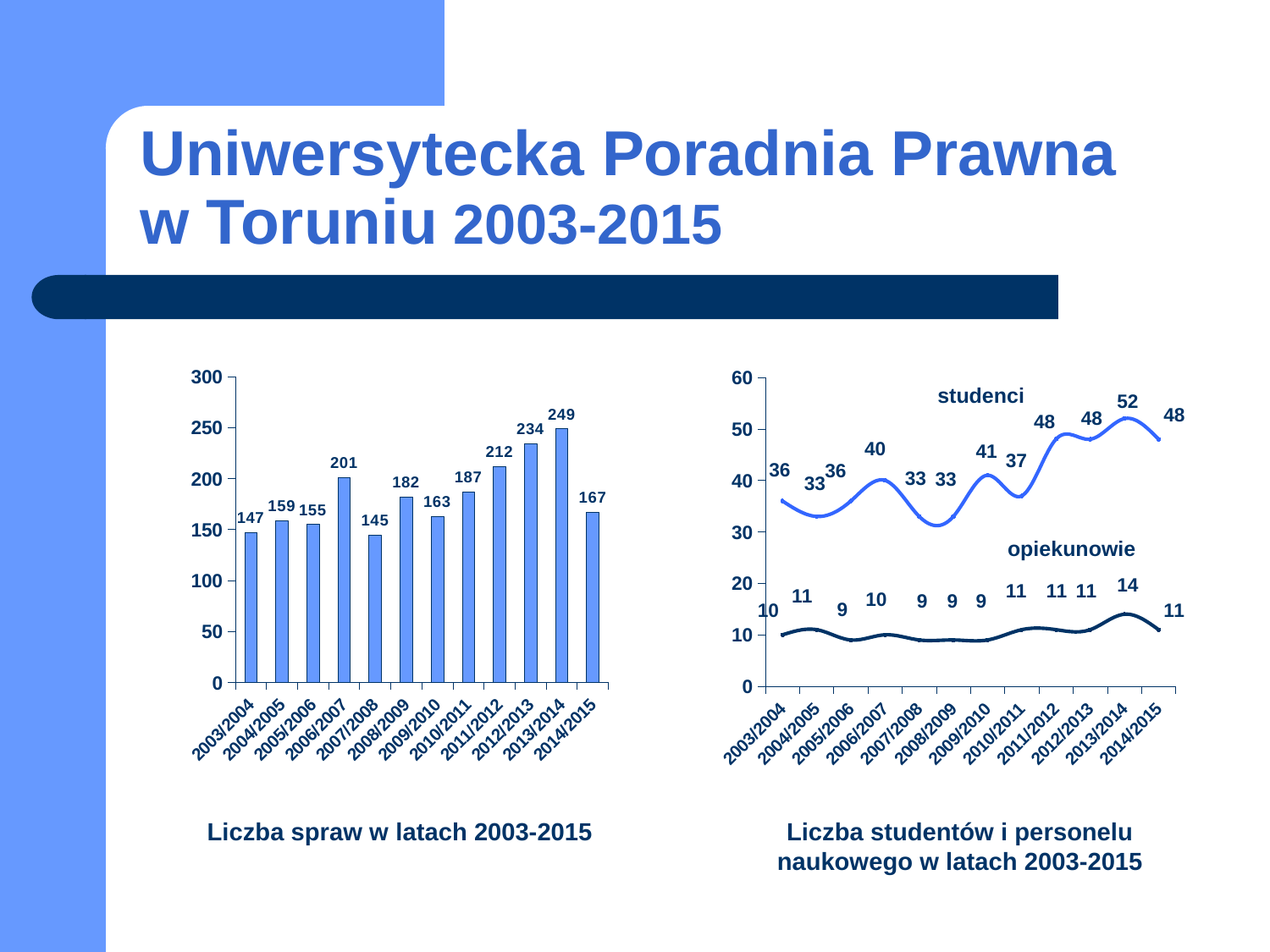
In the left chart (Liczba spraw w latach 2003-2015), how many years are shown on the x axis? 12 In the right chart (Liczba studentów i personelu naukowego), what is the difference between studenci and opiekunowie in 2014/2015? 37 In the right chart (Liczba studentów i personelu naukowego), which is larger in 2009/2010: studenci or opiekunowie? studenci In the left chart (Liczba spraw w latach 2003-2015), which year has the lowest value? 2007/2008 In the right chart (Liczba studentów i personelu naukowego), what is the value for opiekunowie in 2005/2006? 9 What kind of chart is the left chart (Liczba spraw w latach 2003-2015)? bar chart In the right chart (Liczba studentów i personelu naukowego), what is the value for studenci in 2013/2014? 52 In the left chart (Liczba spraw w latach 2003-2015), what is the value for 2006/2007? 201 In the right chart (Liczba studentów i personelu naukowego), in which year is the opiekunowie value highest? 2013/2014 How many series are plotted in the right chart (Liczba studentów i personelu naukowego)? 2 In the left chart (Liczba spraw w latach 2003-2015), which year has the highest value? 2013/2014 In the left chart (Liczba spraw w latach 2003-2015), what is the difference between the values for 2013/2014 and 2014/2015? 82